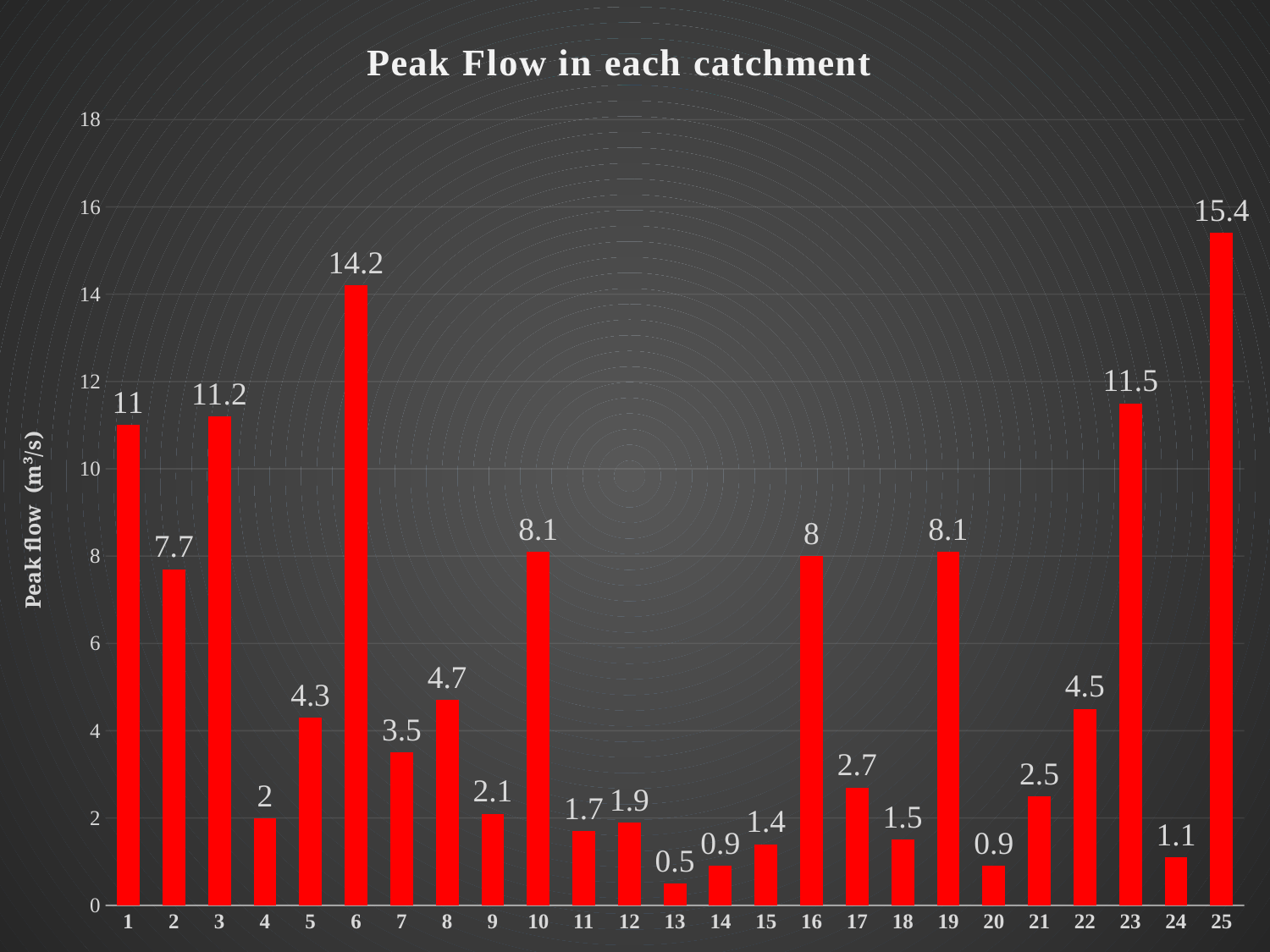
What is the peak flow for catchment 6? 14.2 What is the peak flow for catchment 17? 2.7 What is the difference in peak flow between catchment 3 and catchment 1? 0.2 What kind of chart is this? bar chart What is the difference in peak flow between catchment 25 and catchment 6? 1.2 Is the peak flow for catchment 23 greater or less than 10? greater What is the title of the chart? Peak Flow in each catchment How many catchments are shown on the chart? 25 Which has a larger peak flow, catchment 10 or catchment 16? catchment 10 What is the label of the vertical axis? Peak flow (m³/s) Which catchment has the highest peak flow? 25 Which catchment has the lowest peak flow? 13